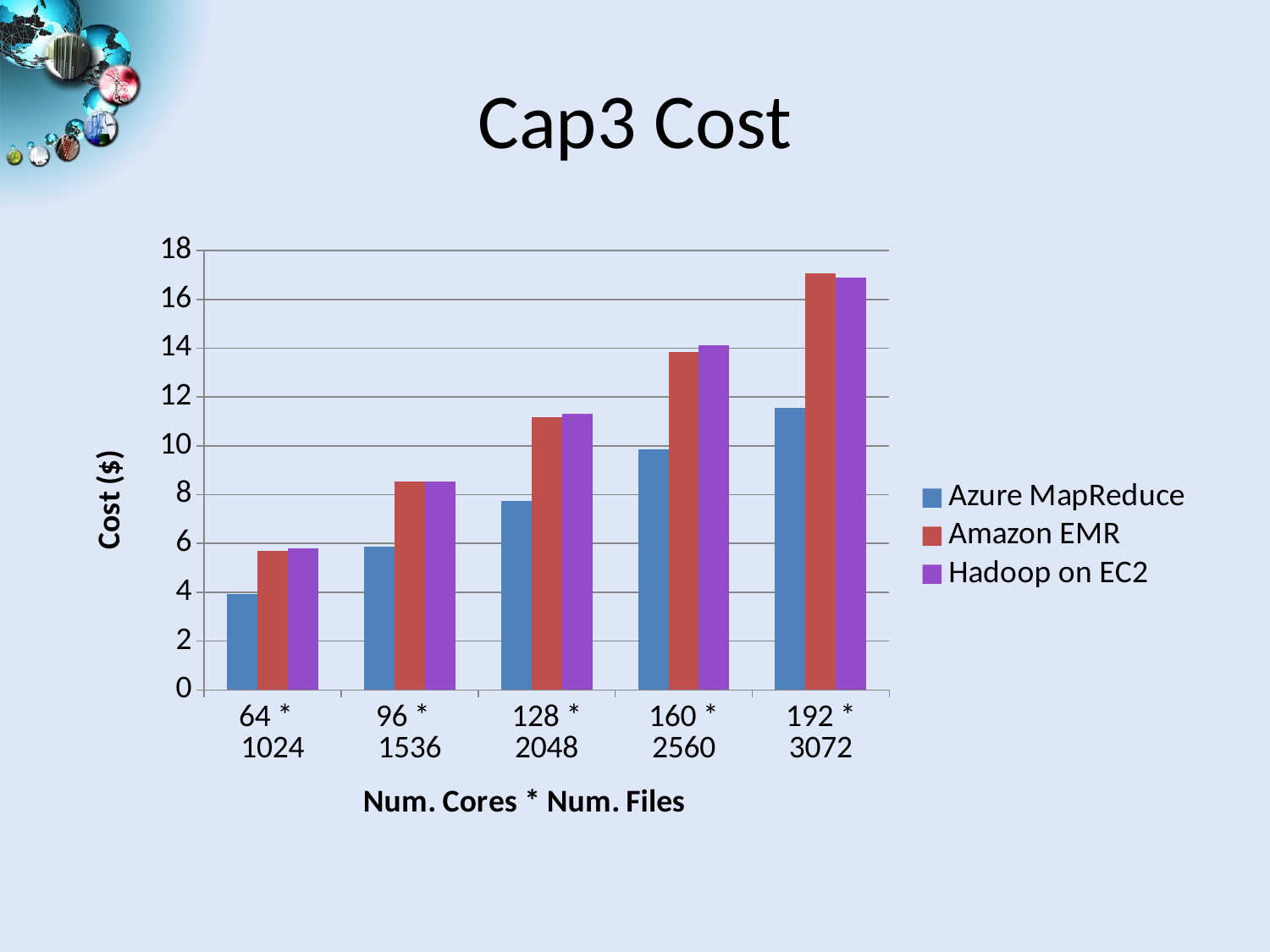
Which series has the lowest cost at 192 * 3072? Azure MapReduce How many series does the legend list? 3 For Azure MapReduce, which category has the highest cost? 192 * 3072 Is the cost for Azure MapReduce at 64 * 1024 greater or less than 6? less Is the cost for Amazon EMR at 192 * 3072 greater or less than 16? greater What kind of chart is shown on the slide? bar chart Is the cost for Azure MapReduce at 192 * 3072 greater or less than 10? greater What is the label of the y axis? Cost ($) Do the Amazon EMR costs rise or fall as Num. Cores * Num. Files increases along the x axis? rise For Amazon EMR, which category has the lowest cost? 64 * 1024 How many categories are shown on the x axis? 5 Which is larger at 160 * 2560, the cost for Azure MapReduce or for Hadoop on EC2? Hadoop on EC2